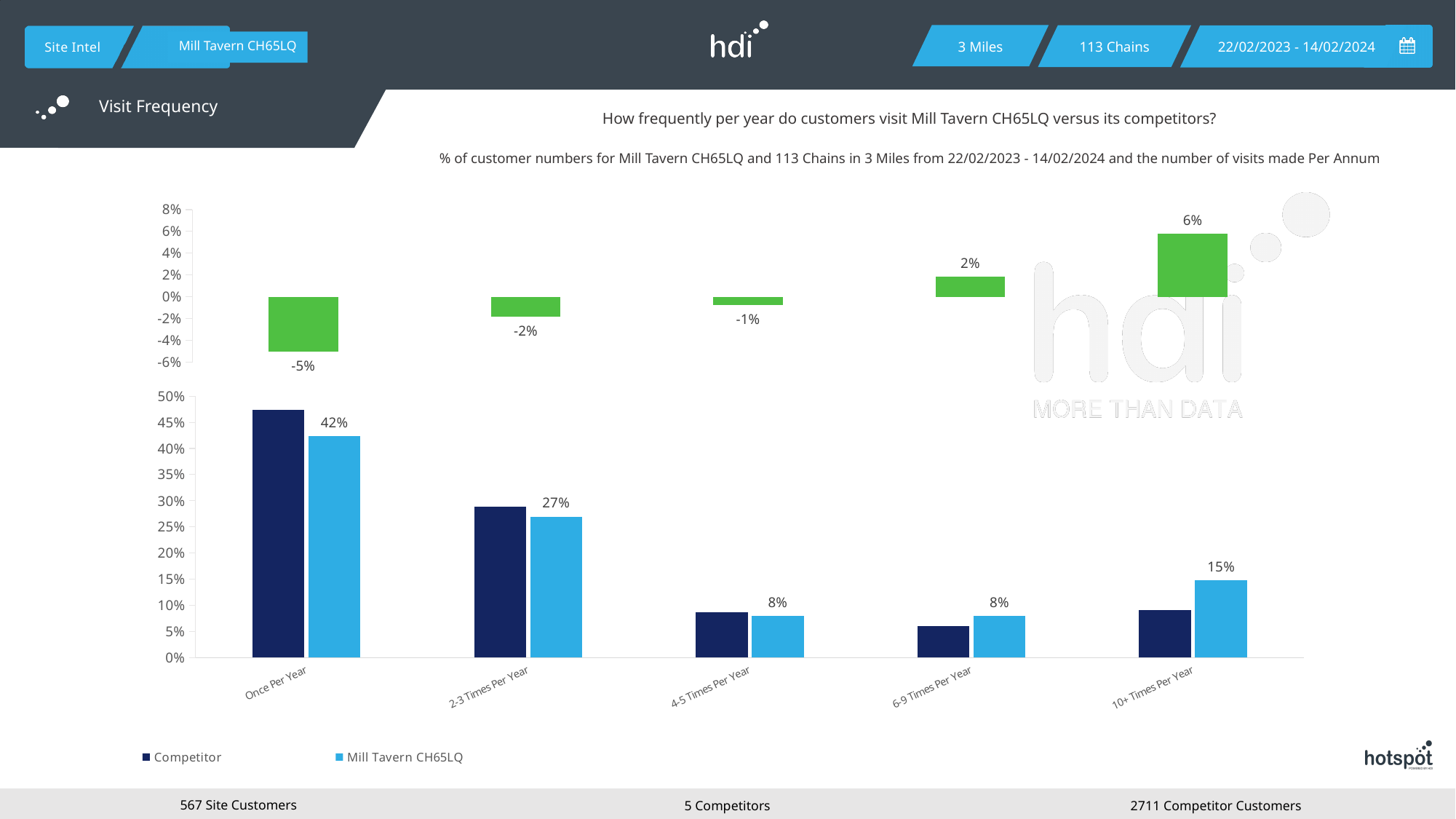
In the bottom chart, is the Competitor value for Once Per Year greater or less than 45%? greater In the bottom chart, is the Competitor value for 6-9 Times Per Year greater or less than 10%? less In the bottom chart, which category has the highest value for Mill Tavern CH65LQ? Once Per Year In the top chart (green bars), which category has the highest value? 10+ Times Per Year In the top chart (green bars), what is the value shown for Once Per Year? -5% How many series does the legend of the bottom chart list? 2 In the bottom chart, what is the value for Mill Tavern CH65LQ in the Once Per Year category? 42% In the bottom chart, for Once Per Year, which is larger: Competitor or Mill Tavern CH65LQ? Competitor In the top chart (green bars), what is the value shown for 10+ Times Per Year? 6% In the bottom chart, what is the value for Mill Tavern CH65LQ in the 10+ Times Per Year category? 15% How many categories are shown on the x axis of the bottom chart? 5 In the top chart (green bars), which category has the lowest value? Once Per Year